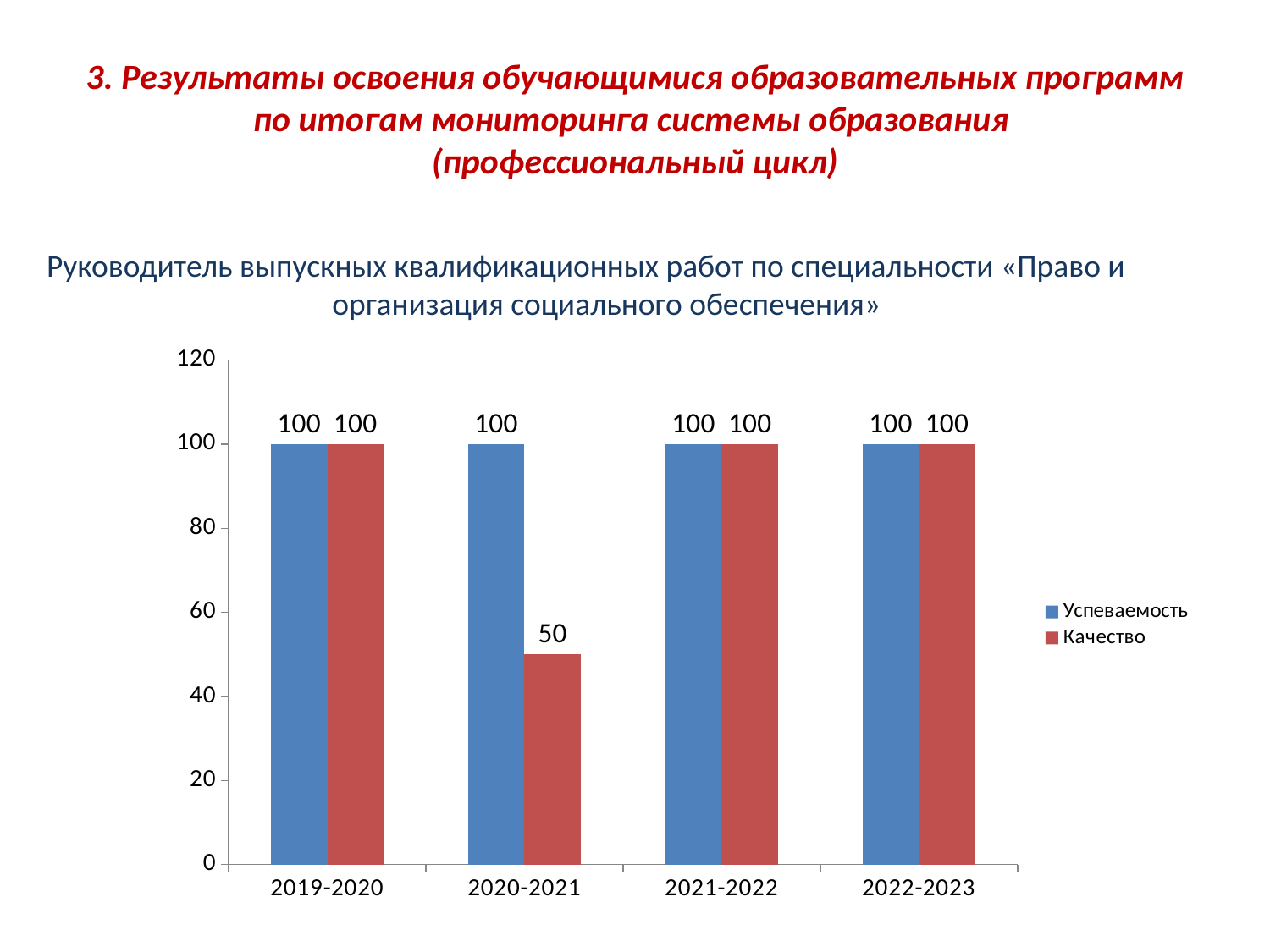
What is the difference between Успеваемость and Качество in 2020-2021? 50 Which series is shown in red? Качество Which category has the lowest value for Качество? 2020-2021 Is the value of Качество for 2020-2021 greater or less than 60? less What is the value of Качество for 2022-2023? 100 How many categories are shown on the x axis? 4 How many series does the legend list? 2 What is the value of Качество for 2020-2021? 50 What is the highest value shown on the vertical axis? 120 What is the value of Успеваемость for 2019-2020? 100 What kind of chart is shown on the slide? bar chart In 2020-2021, which is larger: Успеваемость or Качество? Успеваемость